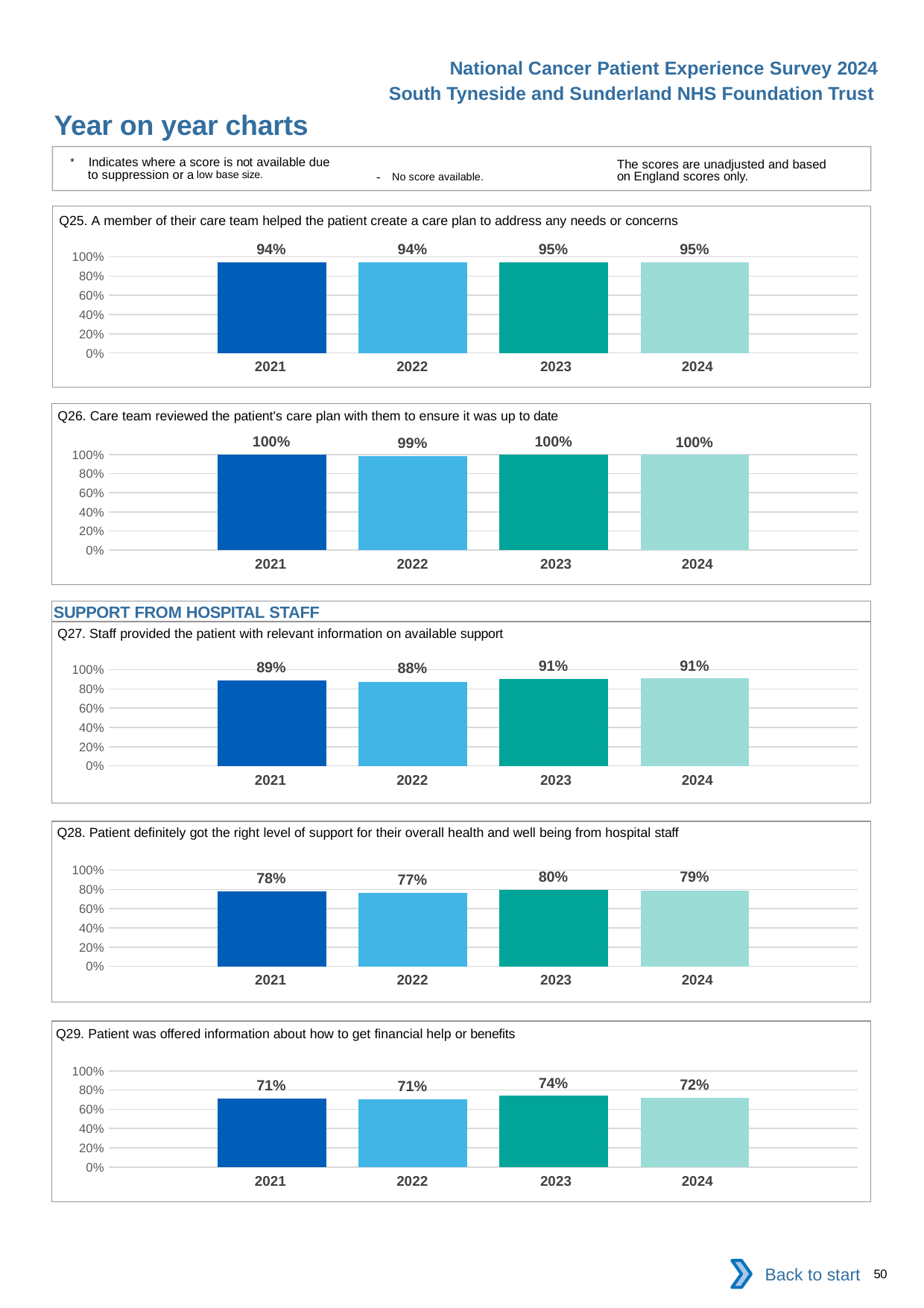
In the Q25 chart, do the values rise or fall from 2021 to 2024? rise In the Q28 chart, which year has the highest value? 2023 In the Q29 chart, what is the value for 2023? 74% In the Q27 chart, what is the difference between the 2023 value and the 2022 value? 3% What kind of chart is the Q26 chart? bar chart In the Q28 chart, is the value for 2021 greater or less than 60%? greater How many years are shown in the Q27 chart? 4 What is the section heading shown above the Q27 chart? SUPPORT FROM HOSPITAL STAFF In the Q25 chart, what is the value for 2024? 95% In the Q28 chart, what is the difference between the 2023 value and the 2021 value? 2% In the Q29 chart, is the value for 2024 larger or smaller than the value for 2023? smaller In the Q26 chart, which year has the lowest value? 2022